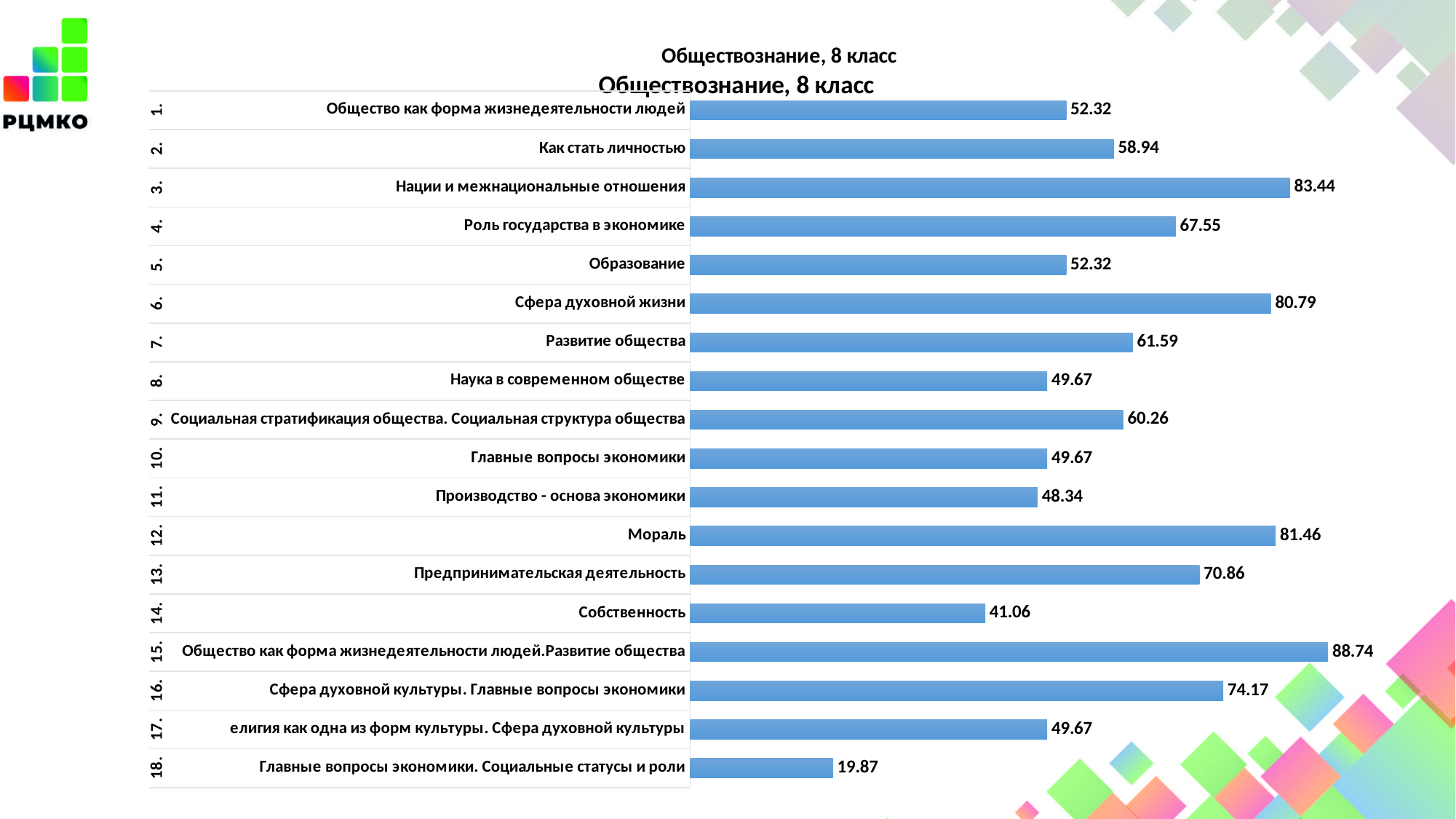
What is the title of the chart? Обществознание, 8 класс Which is larger: the value for "Как стать личностью" or the value for "Сфера духовной жизни"? Сфера духовной жизни What type of chart is shown on the slide? bar chart What is the value for "Мораль"? 81.46 Which category has the lowest value? Главные вопросы экономики. Социальные статусы и роли Which category has the highest value? Общество как форма жизнедеятельности людей.Развитие общества What is the difference between the highest value (88.74) and the lowest value (19.87)? 68.87 What is the value for "Собственность"? 41.06 What is the value for "Предпринимательская деятельность"? 70.86 How many categories (topics) are plotted in the chart? 18 What is the value for "Роль государства в экономике"? 67.55 What is the difference between the values for "Нации и межнациональные отношения" and "Образование"? 31.12